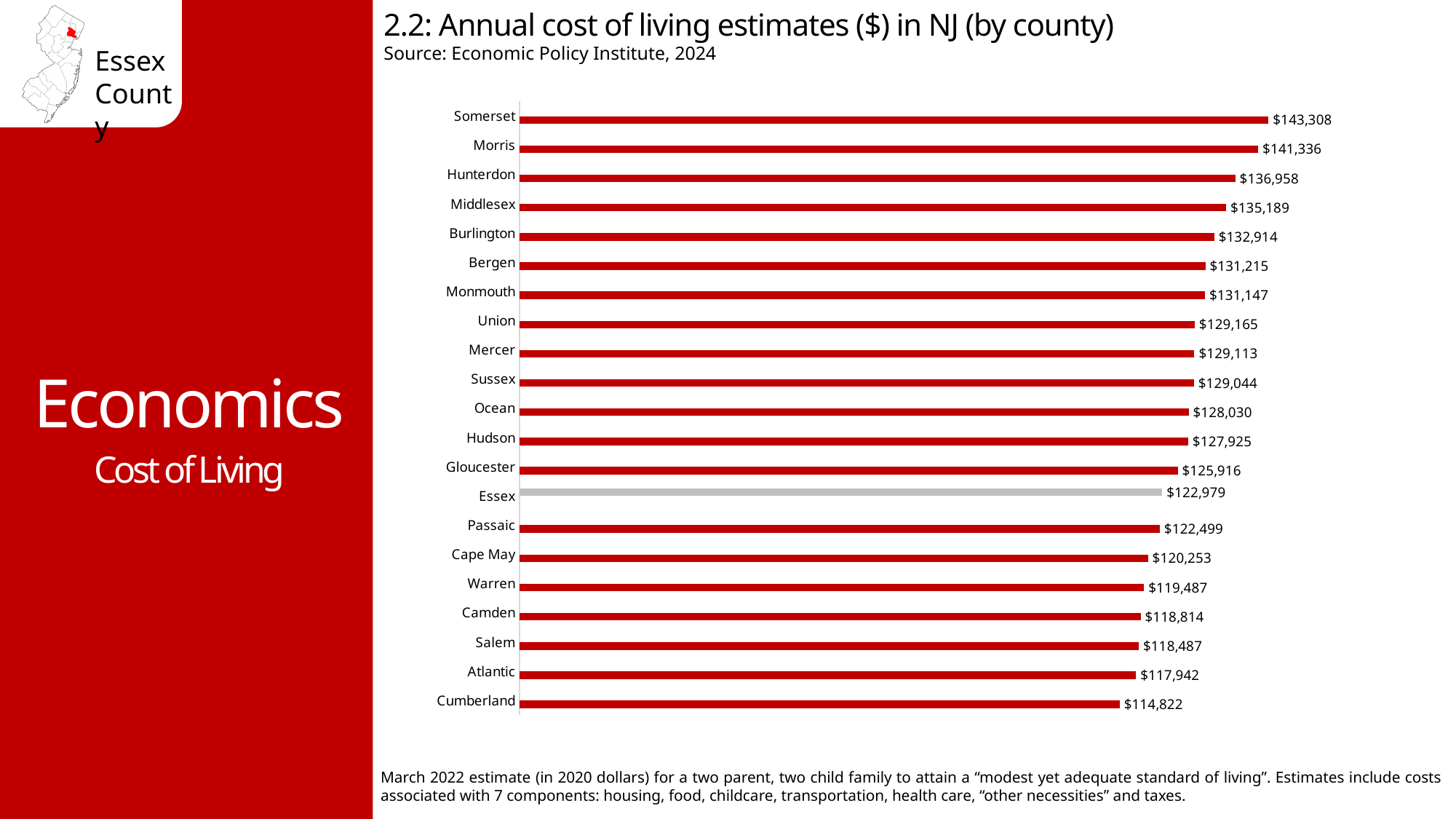
Which county has the highest annual cost of living estimate? Somerset How many counties are shown in the chart? 21 How much higher is Essex County's cost of living estimate than Passaic County's? $480 Which county has the lowest annual cost of living estimate? Cumberland What type of chart is shown on the slide? Bar chart Do the cost of living values increase or decrease going from the top bar to the bottom bar? Decrease What is the annual cost of living estimate for Cape May County? $120,253 What is the difference between the cost of living estimates for Somerset and Cumberland counties? $28,486 Which county has a higher cost of living estimate, Union or Gloucester? Union Which county's bar is shown in gray rather than red? Essex What is the annual cost of living estimate for Bergen County? $131,215 What is the annual cost of living estimate for Essex County? $122,979